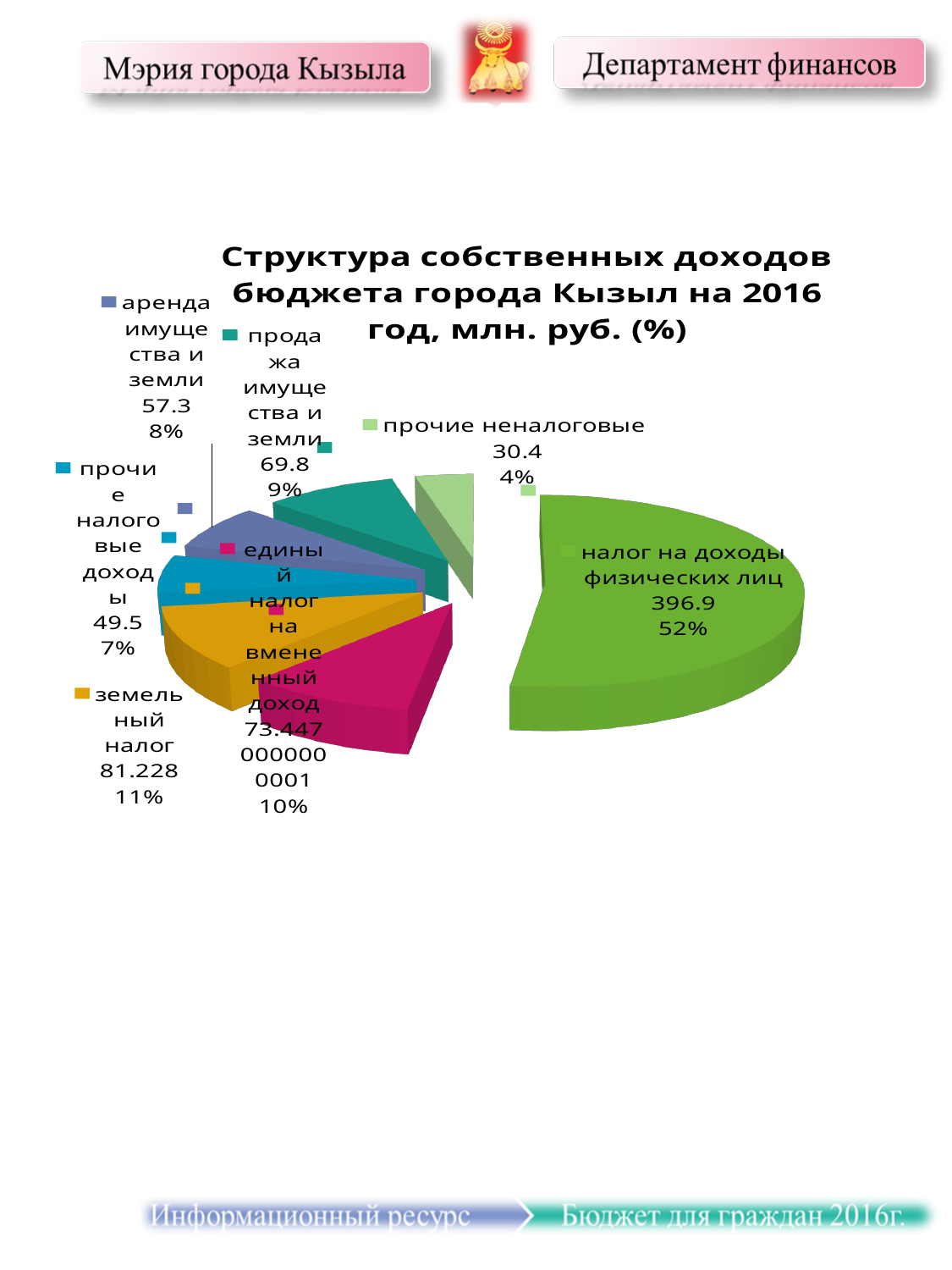
What share of the pie does налог на доходы физических лиц represent? 52% What is the value for налог на доходы физических лиц? 396.9 What share of the pie does прочие неналоговые represent? 4% What is the difference between the value for налог на доходы физических лиц and the value for прочие неналоговые? 366.5 Which category has the largest slice of the pie? налог на доходы физических лиц How many slices does the pie chart have? 7 What is the title of the chart? Структура собственных доходов бюджета города Кызыл на 2016 год, млн. руб. (%) What kind of chart is shown on the slide? pie chart What is the value for земельный налог? 81.228 Which category has the smallest slice of the pie? прочие неналоговые Which is larger, the value for аренда имущества и земли or the value for прочие налоговые доходы? аренда имущества и земли What is the value for продажа имущества и земли? 69.8